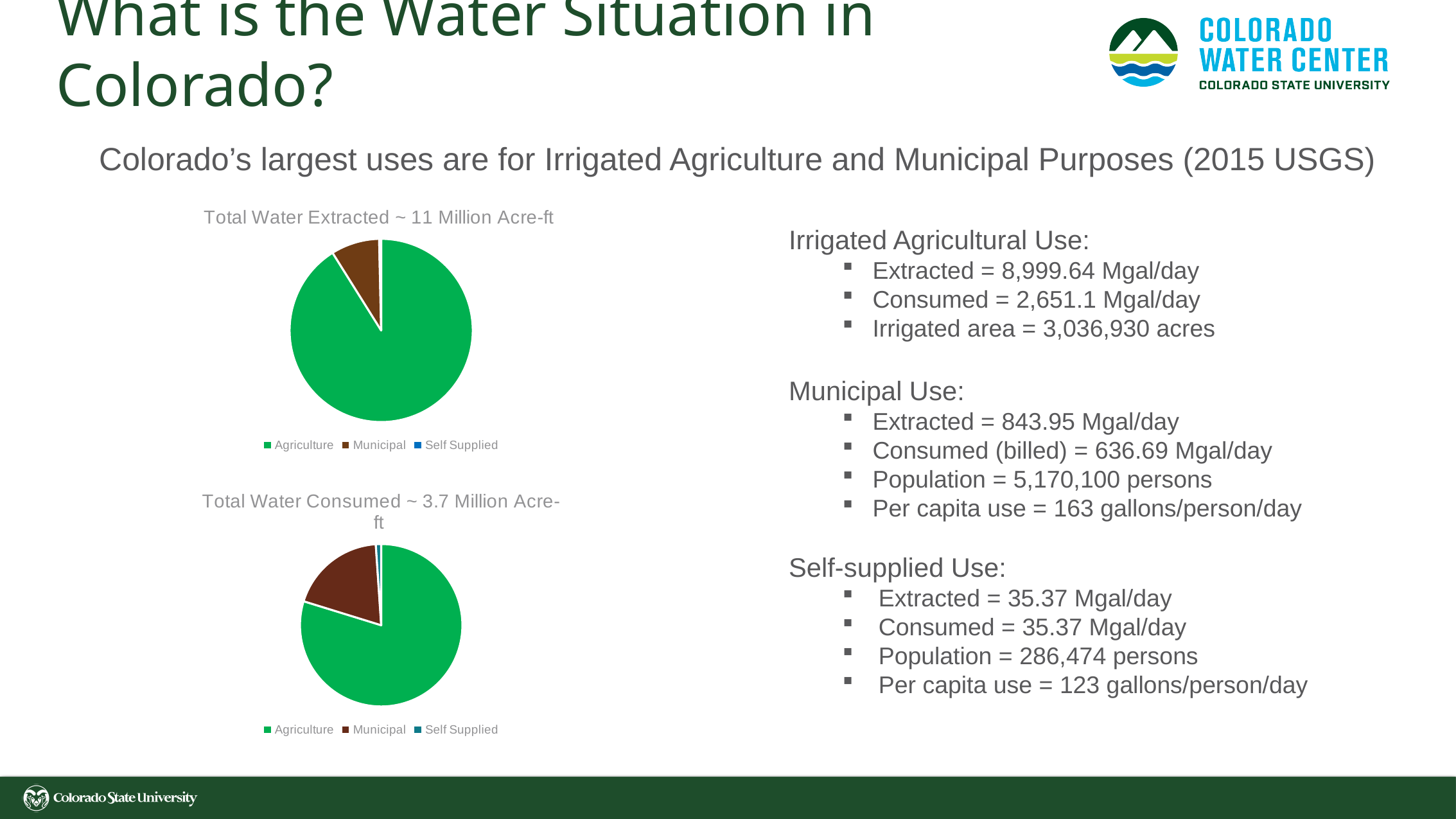
In the 'Total Water Extracted ~ 11 Million Acre-ft' chart, which category has the smallest slice? Self Supplied What kind of chart is the 'Total Water Extracted ~ 11 Million Acre-ft' chart? pie chart In the 'Total Water Consumed ~ 3.7 Million Acre-ft' chart, which category has the largest slice? Agriculture In the 'Total Water Extracted ~ 11 Million Acre-ft' chart, which category has the largest slice? Agriculture In the 'Total Water Consumed ~ 3.7 Million Acre-ft' chart, which slice is larger, Municipal or Self Supplied? Municipal In the 'Total Water Consumed ~ 3.7 Million Acre-ft' chart, what colour is the Agriculture slice? green What is the title of the top pie chart on the slide? Total Water Extracted ~ 11 Million Acre-ft What kind of chart is the 'Total Water Consumed ~ 3.7 Million Acre-ft' chart? pie chart How many categories does the legend of the 'Total Water Consumed ~ 3.7 Million Acre-ft' chart list? 3 In the 'Total Water Consumed ~ 3.7 Million Acre-ft' chart, which category has the smallest slice? Self Supplied How many categories does the legend of the 'Total Water Extracted ~ 11 Million Acre-ft' chart list? 3 In the 'Total Water Extracted ~ 11 Million Acre-ft' chart, which slice is larger, Agriculture or Municipal? Agriculture